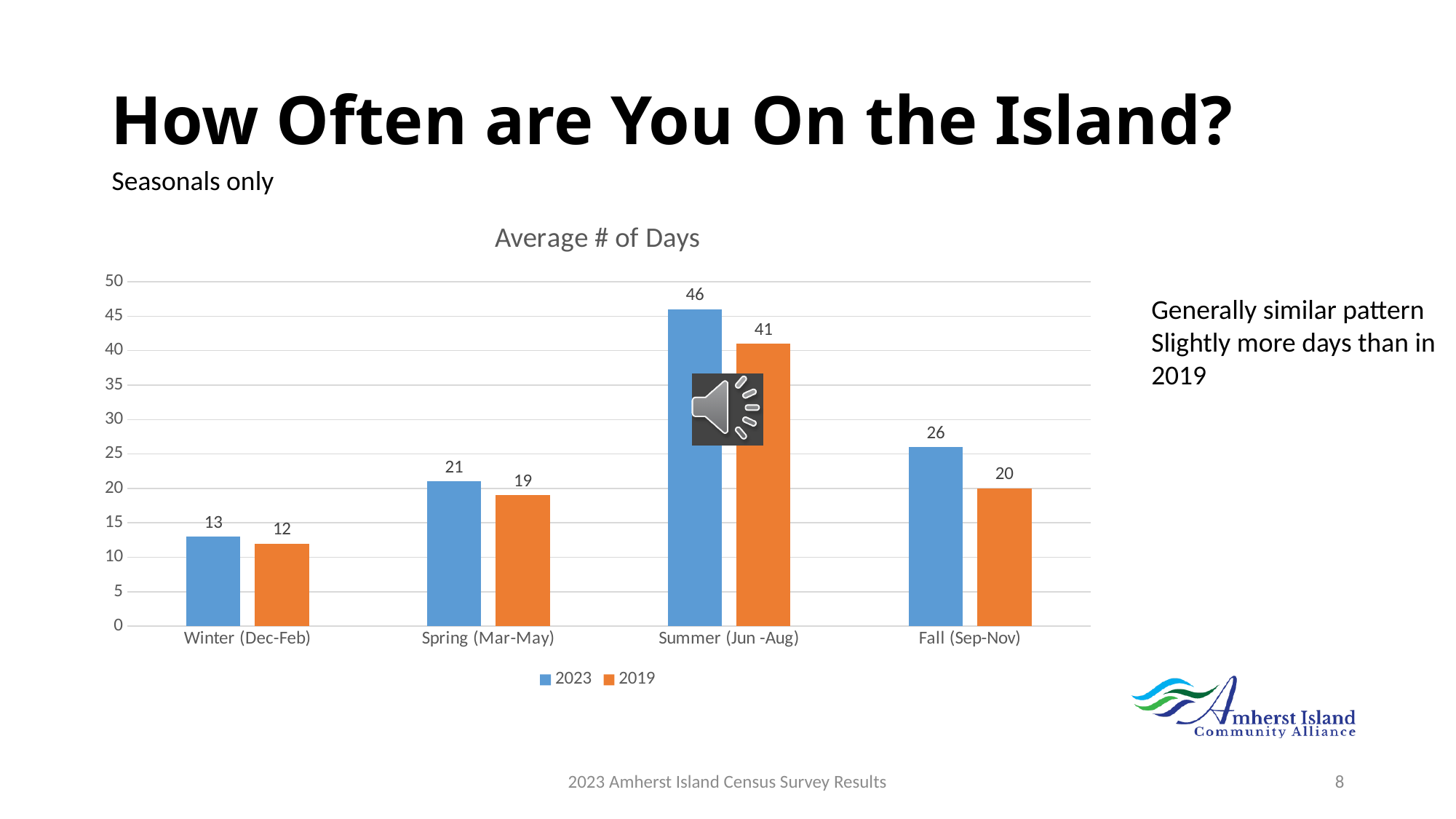
How many series does the legend list? 2 What is the title of the chart? Average # of Days What is the average number of days for Fall (Sep-Nov) in 2023? 26 What kind of chart is shown on the slide? Bar chart How many seasons are shown on the x axis? 4 Which colour represents the 2019 series? Orange What is the difference between the 2023 and 2019 values for Fall (Sep-Nov)? 6 What is the average number of days for Winter (Dec-Feb) in 2019? 12 Which season has the lowest average number of days in 2023? Winter (Dec-Feb) What is the average number of days for Summer (Jun-Aug) in 2023? 46 Which is larger, the 2023 value for Spring (Mar-May) or the 2019 value for Spring (Mar-May)? 2023 Which season has the highest average number of days in 2019? Summer (Jun -Aug)